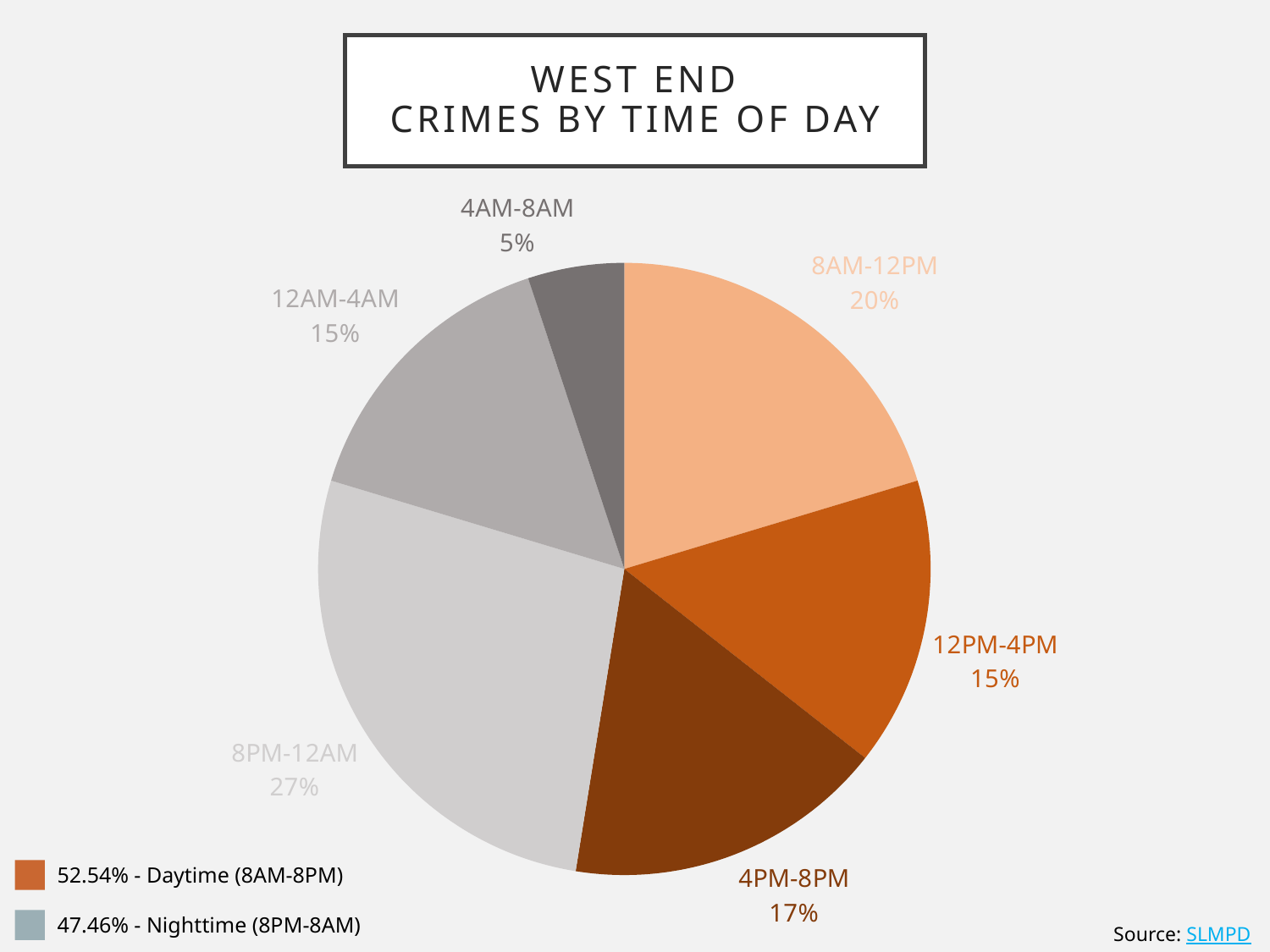
According to the legend, what percentage of crimes occurred during daytime (8AM-8PM)? 52.54% Which time period has the largest share of crimes? 8PM-12AM What share of crimes occurred between 8AM and 12PM? 20% What is the difference in percentage points between the 8PM-12AM slice and the 4PM-8PM slice? 10 What kind of chart is shown on the slide? pie chart Which has a larger share of crimes, 8AM-12PM or 12PM-4PM? 8AM-12PM What is the title of the chart? West End Crimes by Time of Day What share of crimes occurred between 4PM and 8PM? 17% Which time period has the smallest share of crimes? 4AM-8AM What share of crimes occurred between 8PM and 12AM? 27% How many time periods are shown in the pie chart? 6 What share of crimes occurred between 4AM and 8AM? 5%